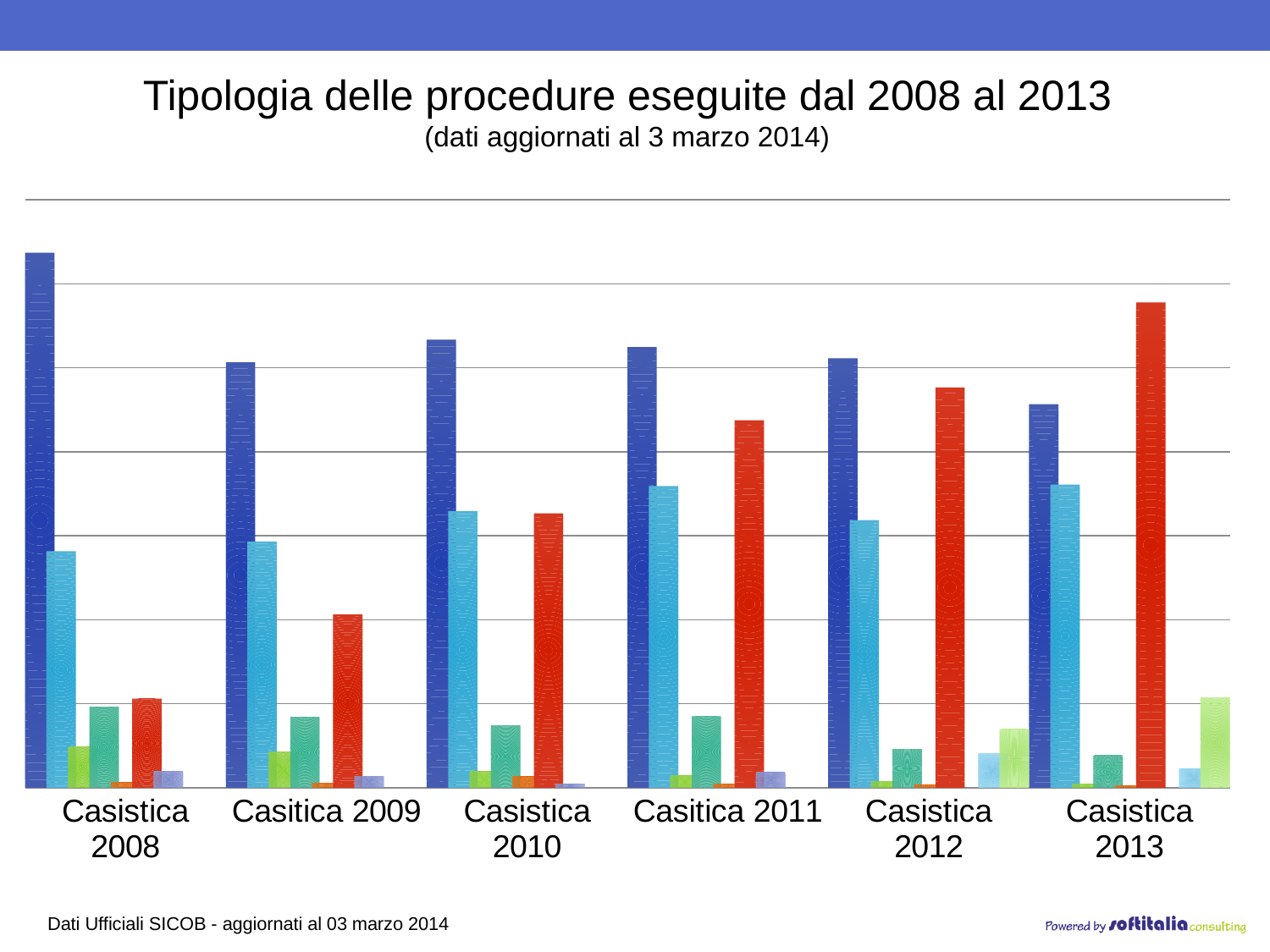
How many categories are shown along the x axis of the chart? 6 What is the title of the chart on the slide? Tipologia delle procedure eseguite dal 2008 al 2013 In which category is the light green bar the tallest? Casistica 2013 In which category is the red bar the tallest? Casistica 2013 In Casistica 2008, which is taller: the dark blue bar or the light blue bar? The dark blue bar What kind of chart is shown on the slide? Bar chart What subtitle appears under the chart title? (dati aggiornati al 3 marzo 2014) Do the red bars rise or fall from Casistica 2008 to Casistica 2013? Rise In Casistica 2013, which is taller: the red bar or the dark blue bar? The red bar Do the dark blue bars rise or fall from Casistica 2010 to Casistica 2013? Fall In which category is the dark blue bar the tallest? Casistica 2008 In which category is the red bar the shortest? Casistica 2008